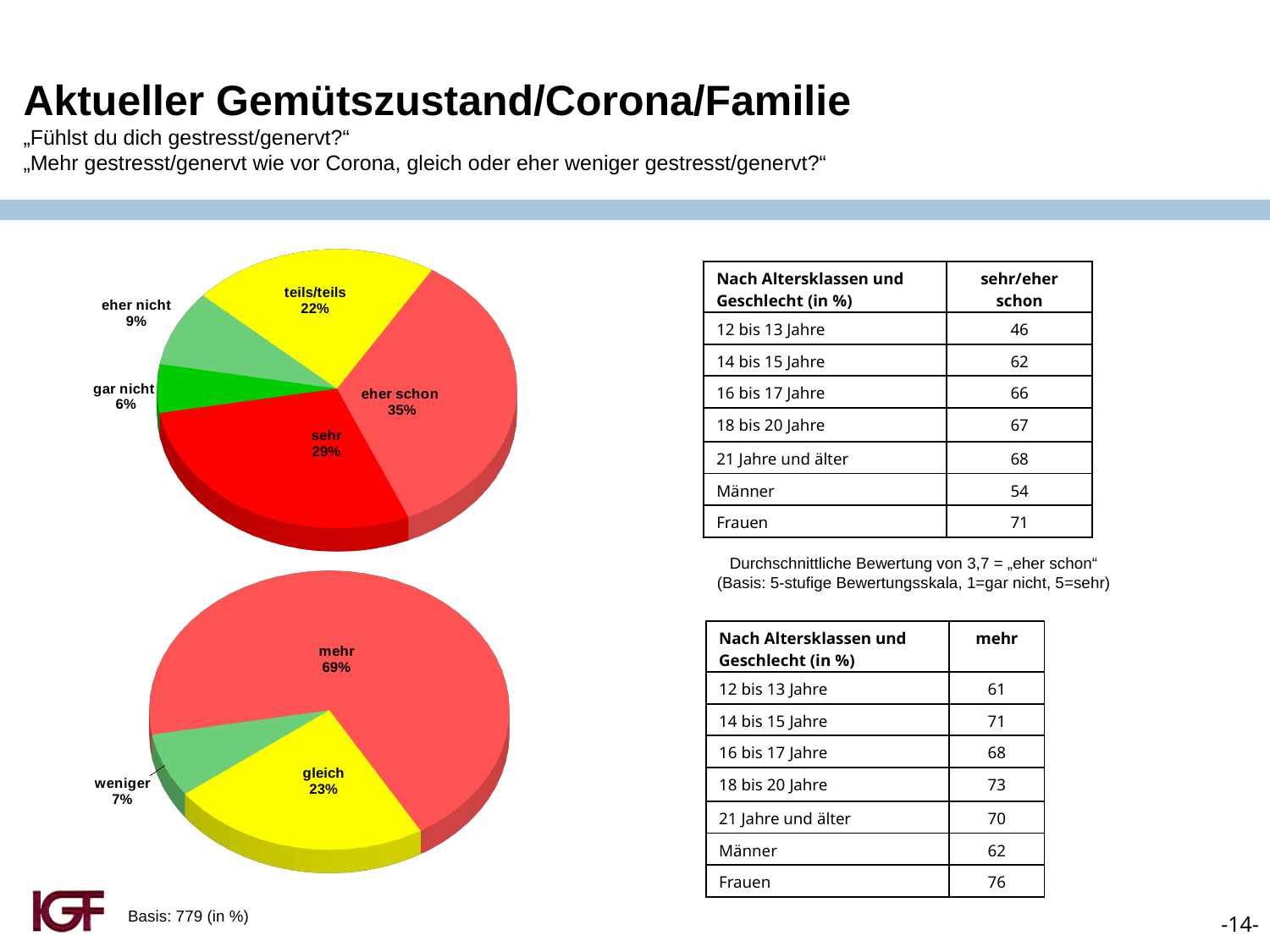
In the bottom pie chart, what is the difference in percentage points between "mehr" and "gleich"? 46 What type of chart is the bottom chart on the slide? pie chart In the bottom pie chart, what percentage is shown for "weniger"? 7% In the top pie chart, which category has the largest share? eher schon In the top pie chart, which is larger: "eher nicht" or "teils/teils"? teils/teils In the top pie chart, which category has the smallest share? gar nicht In the bottom pie chart, what percentage is shown for "mehr"? 69% How many slices does the bottom pie chart have? 3 In the top pie chart, what percentage is shown for "gar nicht"? 6% In the top pie chart, what is the difference in percentage points between "sehr" and "teils/teils"? 7 How many slices does the top pie chart have? 5 In the top pie chart, what percentage is shown for "eher schon"? 35%